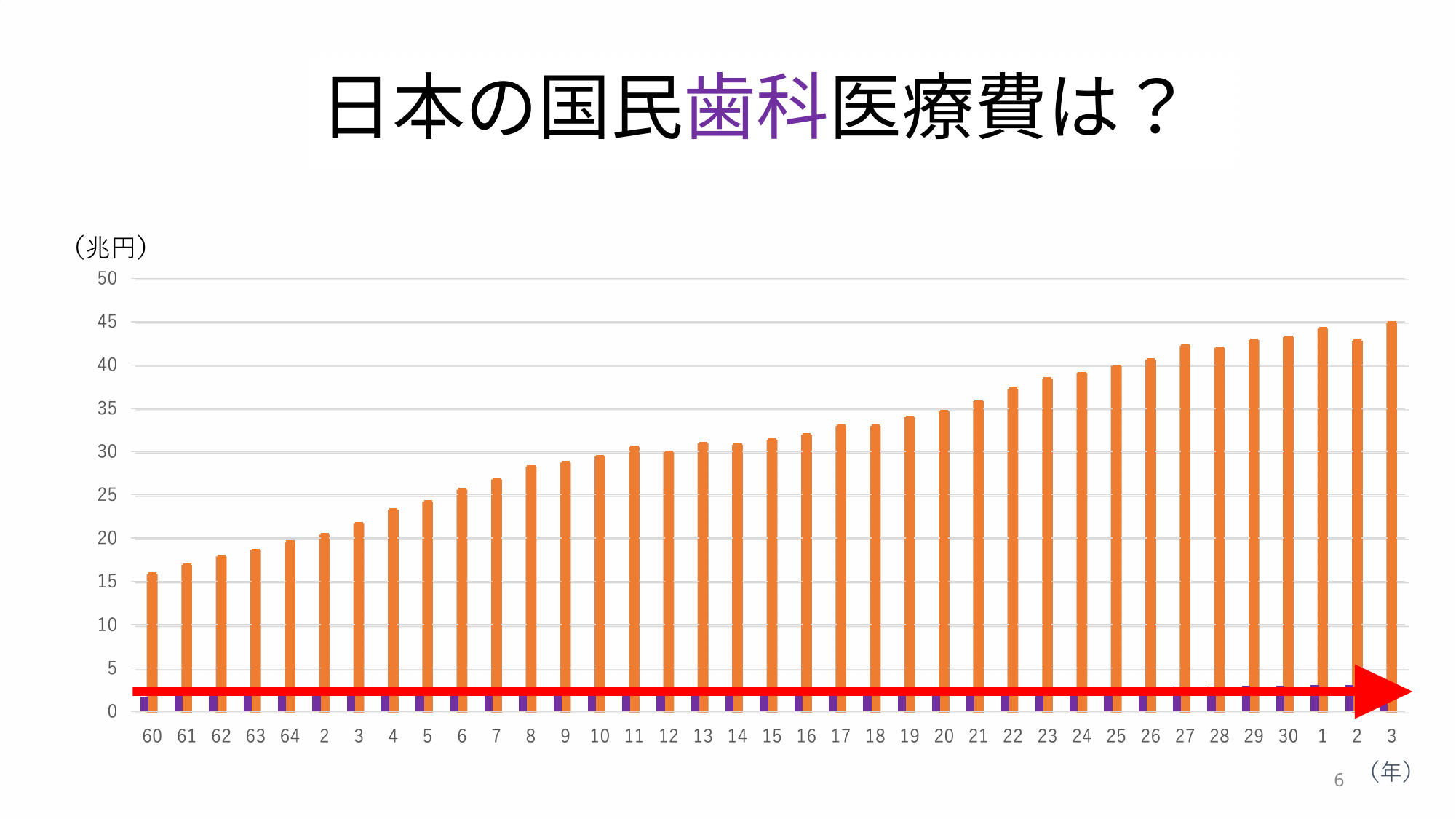
Do the orange bars generally rise or fall from left to right along the x axis? rise How many year categories are shown along the x axis? 37 What is the title of the slide above the chart? 日本の国民歯科医療費は？ Is the orange bar for year 5 greater or less than 25? less Is the orange bar for year 60 greater or less than 10? greater What unit is shown at the top of the vertical axis? 兆円 Which year has the lowest orange bar? 60 Which is larger, the orange bar for year 60 or the orange bar for year 30? year 30 What kind of chart is shown on the slide? bar chart Is the orange bar for year 17 greater or less than 30? greater